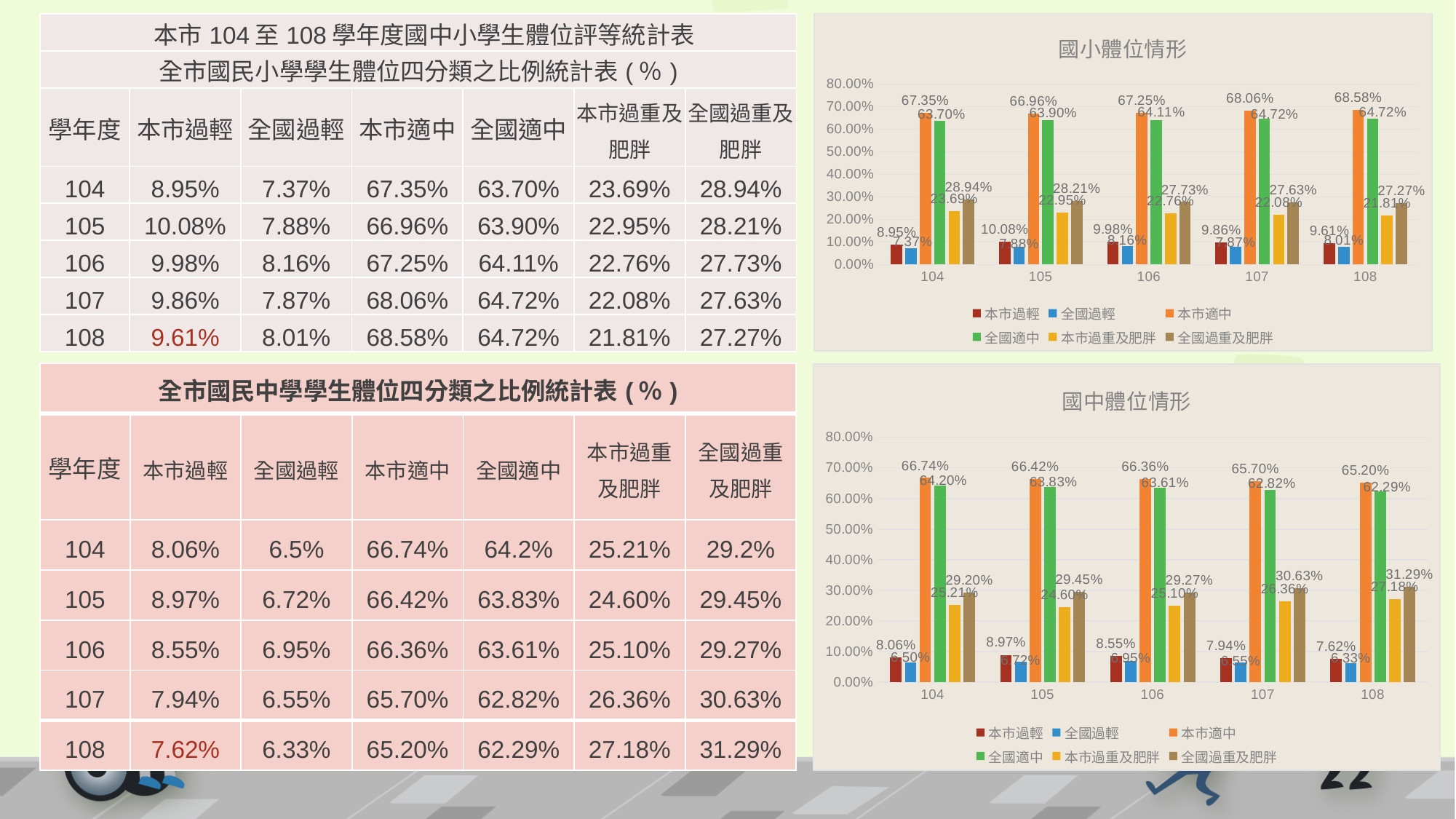
What type of chart is the 國小體位情形 chart? Bar chart In the 國小體位情形 chart, which year has the highest value for 本市適中? 108 In the 國中體位情形 chart, is the value of 全國過重及肥胖 for 108 greater or less than 30.00%? greater In the 國中體位情形 chart, which year has the lowest value for 本市過輕? 108 How many series does the legend of the 國中體位情形 chart list? 6 How many years are shown on the x axis of the 國小體位情形 chart? 5 In the 國中體位情形 chart, what is the value of 本市過重及肥胖 for 107? 26.36% In the 國小體位情形 chart, what is the value of 本市適中 for 108? 68.58% In the 國中體位情形 chart, what is the difference between 全國過重及肥胖 and 本市過重及肥胖 for 108? 4.11% In the 國中體位情形 chart, what is the value of 全國適中 for 105? 63.83% In the 國小體位情形 chart, what is the value of 全國過重及肥胖 for 104? 28.94% In the 國小體位情形 chart, which is larger for 106: 本市適中 or 全國適中? 本市適中